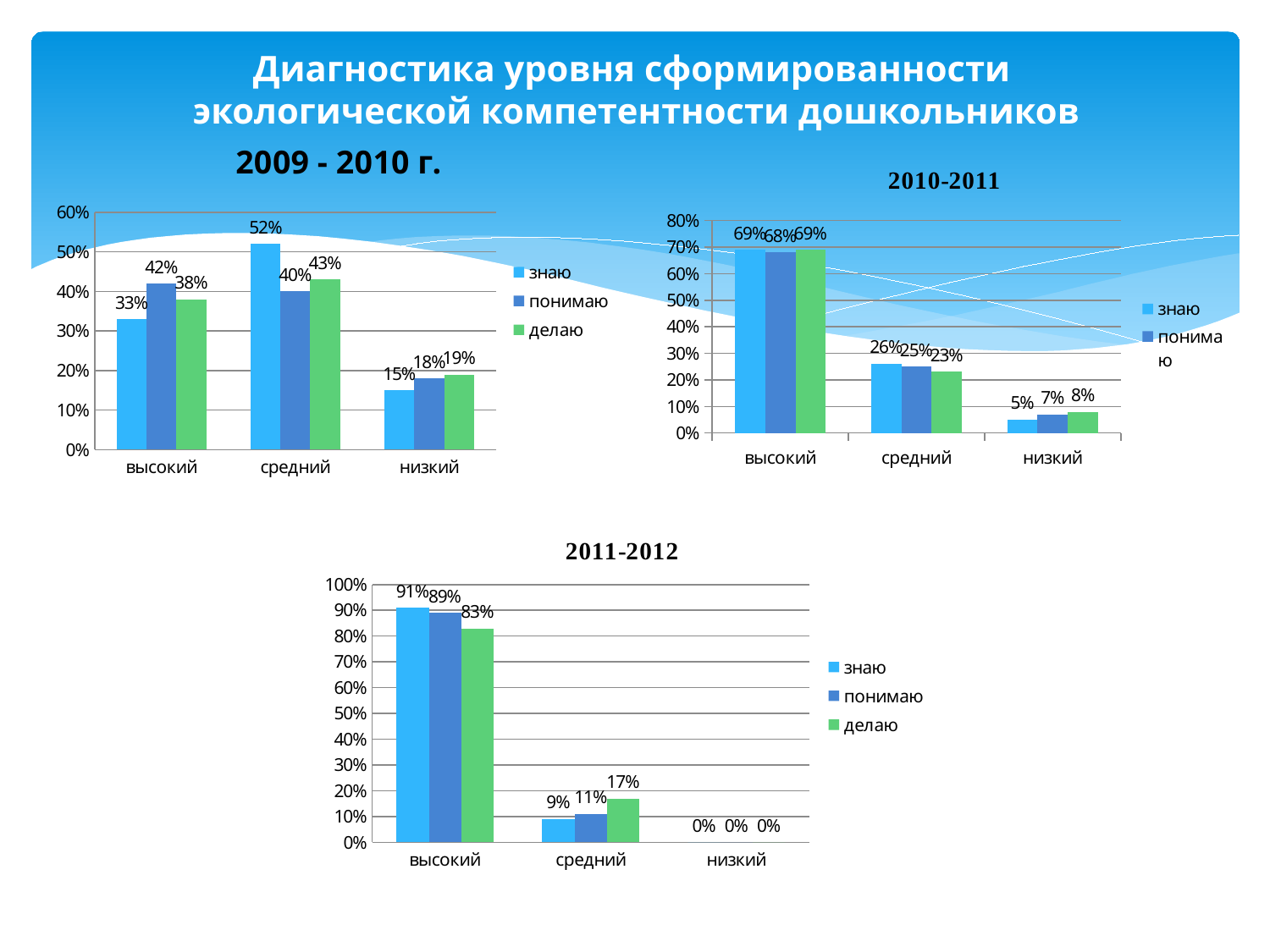
In the 2010-2011 chart, what is the value of знаю for низкий? 5% In the 2009 - 2010 г. chart, what is the value of понимаю for высокий? 42% How many series does the legend of the 2011-2012 chart list? 3 In the 2009 - 2010 г. chart, which category has the lowest value for делаю? низкий In the 2010-2011 chart, what is the value of делаю for средний? 23% What type of chart is the 2011-2012 chart? bar chart In the 2009 - 2010 г. chart, what is the difference between знаю for средний and знаю for высокий? 19% In the 2011-2012 chart, what is the value of делаю for средний? 17% In the 2009 - 2010 г. chart, what is the value of знаю for средний? 52% In the 2010-2011 chart, which category has the highest value for знаю? высокий In the 2011-2012 chart, what is the value of делаю for высокий? 83% In the 2011-2012 chart, which is larger for средний: знаю or понимаю? понимаю